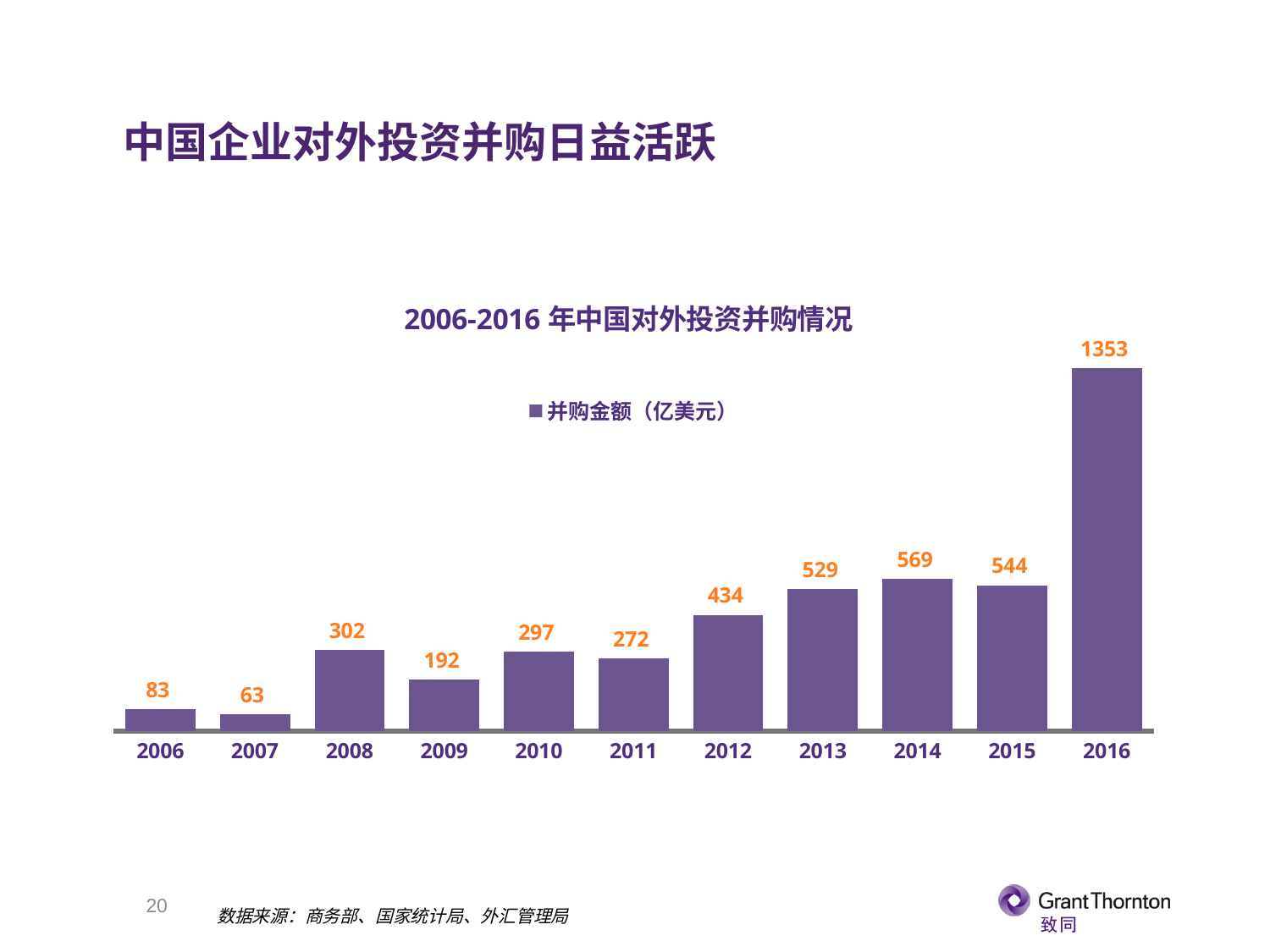
Which year has the lowest 并购金额 (亿美元)? 2007 What is the title of the chart? 2006-2016 年中国对外投资并购情况 What kind of chart is shown on the slide? Bar chart How many series does the legend list? 1 What is the difference in 并购金额 (亿美元) between 2016 and 2015? 809 What is the difference in 并购金额 (亿美元) between 2014 and 2013? 40 Which year has a larger 并购金额 (亿美元), 2010 or 2011? 2010 What is the 并购金额 (亿美元) value for 2012? 434 How many years are shown on the x axis of the chart? 11 Which year has the highest 并购金额 (亿美元)? 2016 What is the 并购金额 (亿美元) value for 2009? 192 What is the 并购金额 (亿美元) value for 2016? 1353